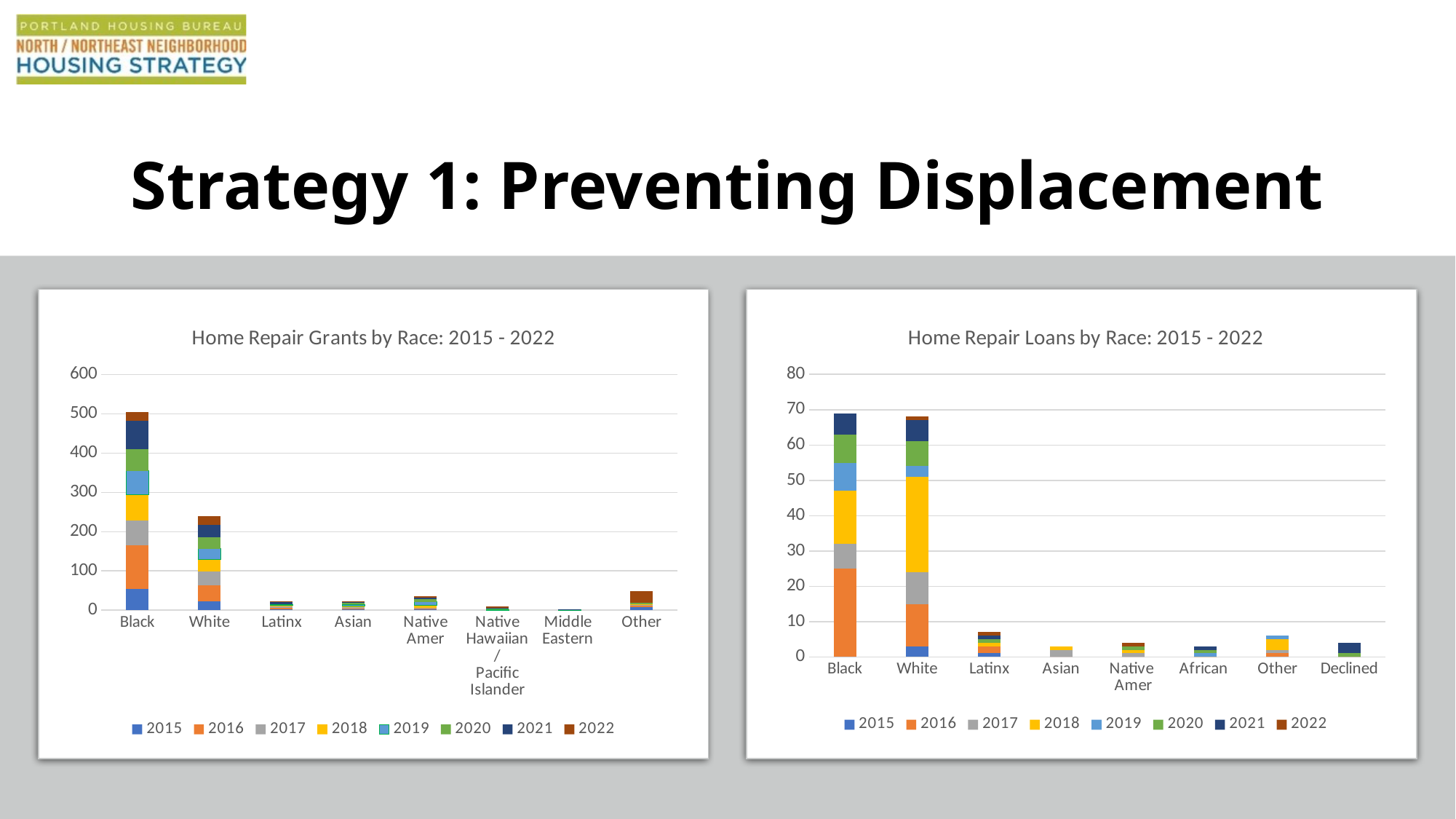
How many race categories are shown on the x axis of the 'Home Repair Grants by Race: 2015 - 2022' chart? 8 In the 'Home Repair Grants by Race: 2015 - 2022' chart, which race category has the shortest stacked bar? Middle Eastern In the 'Home Repair Grants by Race: 2015 - 2022' chart, is the total stacked bar for Latinx greater or less than 100? less How many series does the legend of the 'Home Repair Grants by Race: 2015 - 2022' chart list? 8 In the 'Home Repair Grants by Race: 2015 - 2022' chart, which stacked bar is taller, White or Asian? White What is the title of the chart on the right side of the slide? Home Repair Loans by Race: 2015 - 2022 How many race categories are shown on the x axis of the 'Home Repair Loans by Race: 2015 - 2022' chart? 8 In the 'Home Repair Grants by Race: 2015 - 2022' chart, is the total stacked bar for Black greater or less than 400? greater In the 'Home Repair Grants by Race: 2015 - 2022' chart, which race category has the tallest stacked bar? Black What kind of chart is the 'Home Repair Grants by Race: 2015 - 2022' chart? Stacked bar chart In the 'Home Repair Loans by Race: 2015 - 2022' chart, is the total stacked bar for Black greater or less than 60? greater In the 'Home Repair Loans by Race: 2015 - 2022' chart, which stacked bar is taller, White or Latinx? White